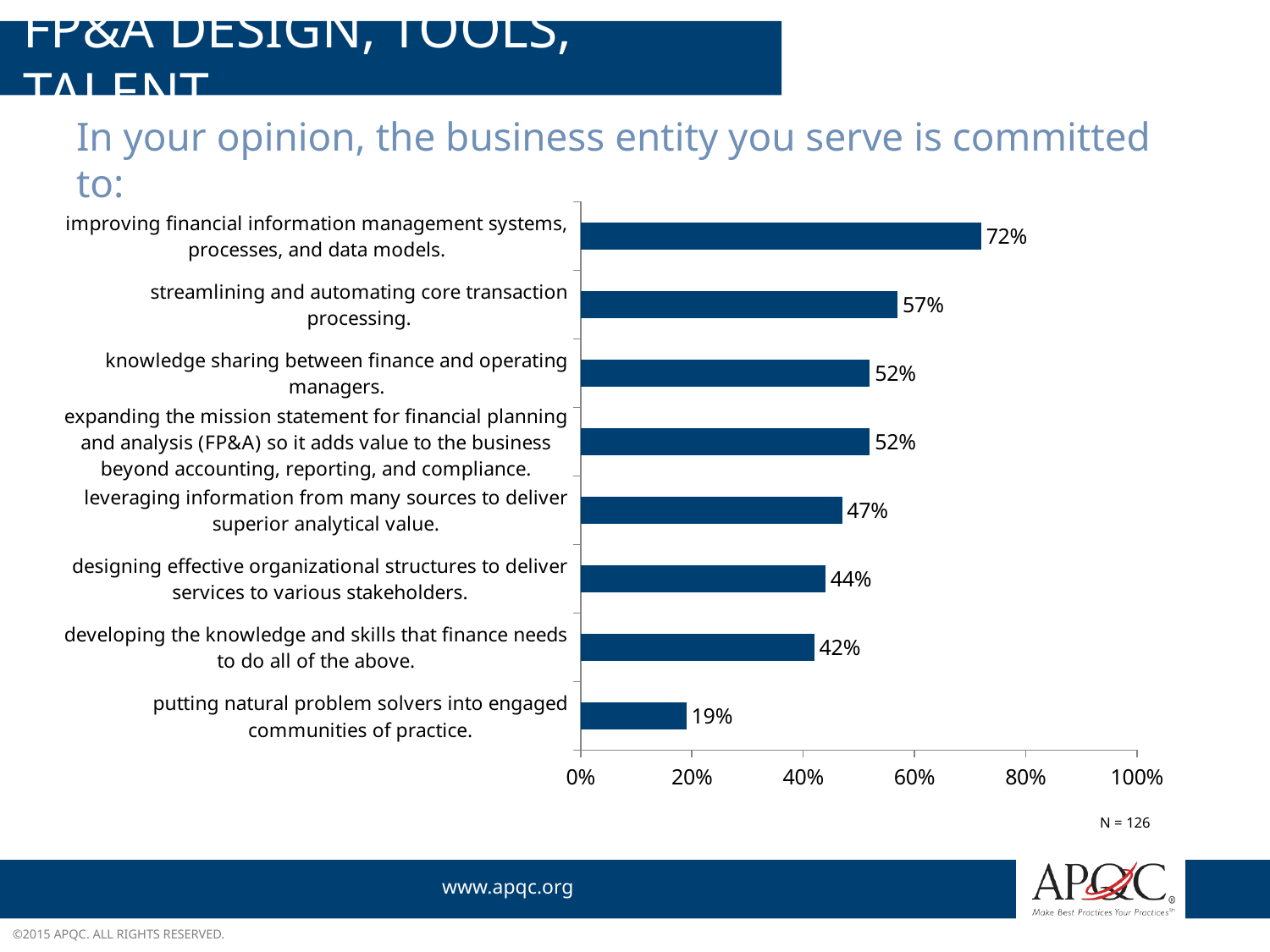
Which category has the highest value? improving financial information management systems, processes, and data models. What is the difference between the values for 'improving financial information management systems, processes, and data models' and 'streamlining and automating core transaction processing'? 15% What is the sample size (N) shown on the slide? 126 How many categories are shown in the chart? 8 Which category has the lowest value? putting natural problem solvers into engaged communities of practice. What is the value for 'streamlining and automating core transaction processing'? 57% Which is larger: the value for 'leveraging information from many sources to deliver superior analytical value' or 'developing the knowledge and skills that finance needs to do all of the above'? leveraging information from many sources to deliver superior analytical value. What kind of chart is shown on the slide? bar chart What is the maximum value shown on the horizontal axis? 100% What percentage of respondents said their business entity is committed to improving financial information management systems, processes, and data models? 72% What is the value for 'designing effective organizational structures to deliver services to various stakeholders'? 44% What is the value for 'putting natural problem solvers into engaged communities of practice'? 19%